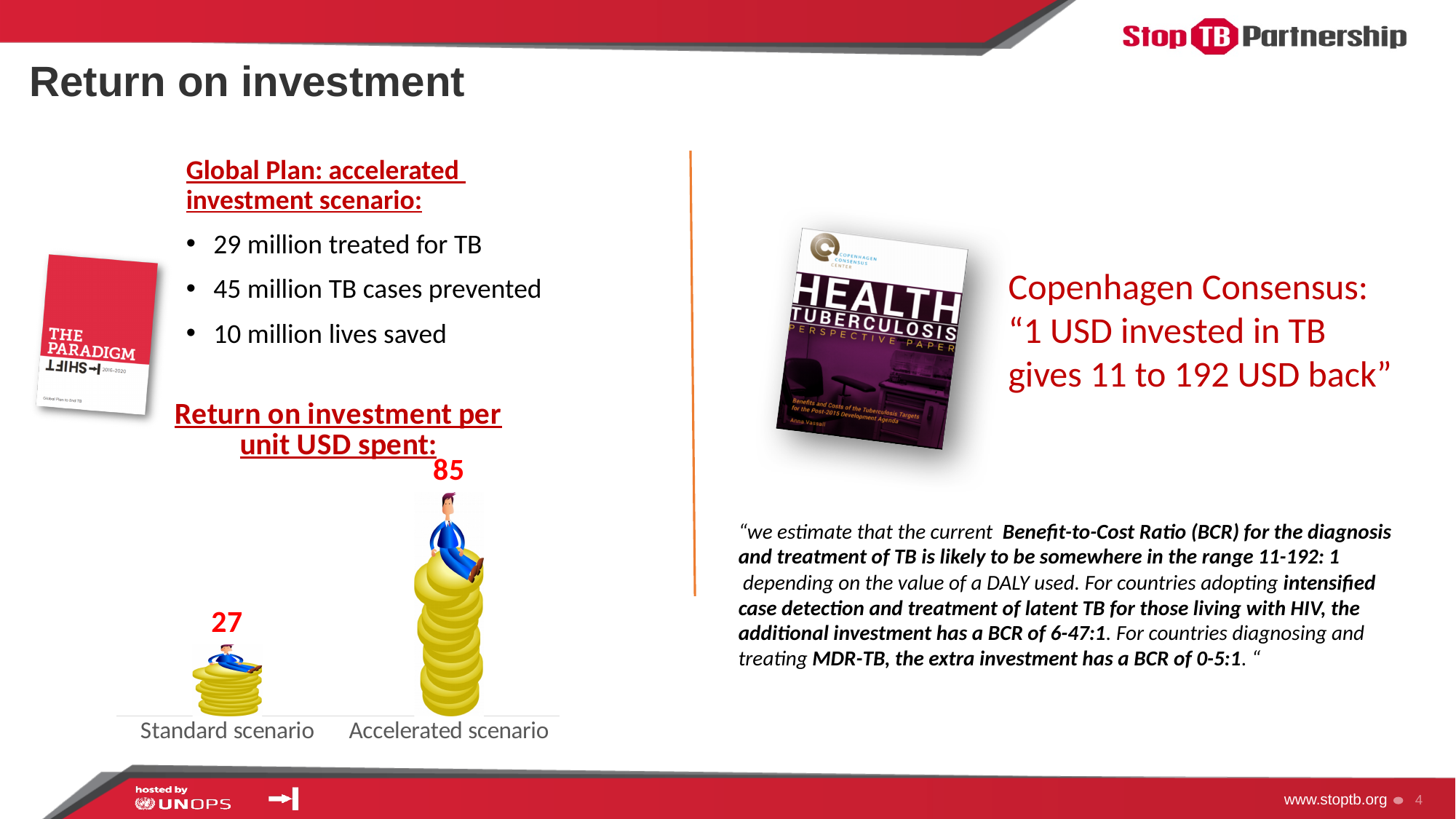
What is the title of the chart showing the two scenarios? Return on investment per unit USD spent Which scenario has the lower return on investment per unit USD spent? Standard scenario What kind of chart is used to show the return on investment per unit USD spent? Bar chart Is the return on investment larger for the Standard scenario or the Accelerated scenario? Accelerated scenario Which scenario has the higher return on investment per unit USD spent? Accelerated scenario What are the bars in the return on investment chart drawn as? Stacks of gold coins How many scenarios are shown in the return on investment chart? 2 What is the difference in return on investment between the Accelerated scenario and the Standard scenario? 58 What is the return on investment per unit USD spent for the Standard scenario? 27 What is the return on investment per unit USD spent for the Accelerated scenario? 85